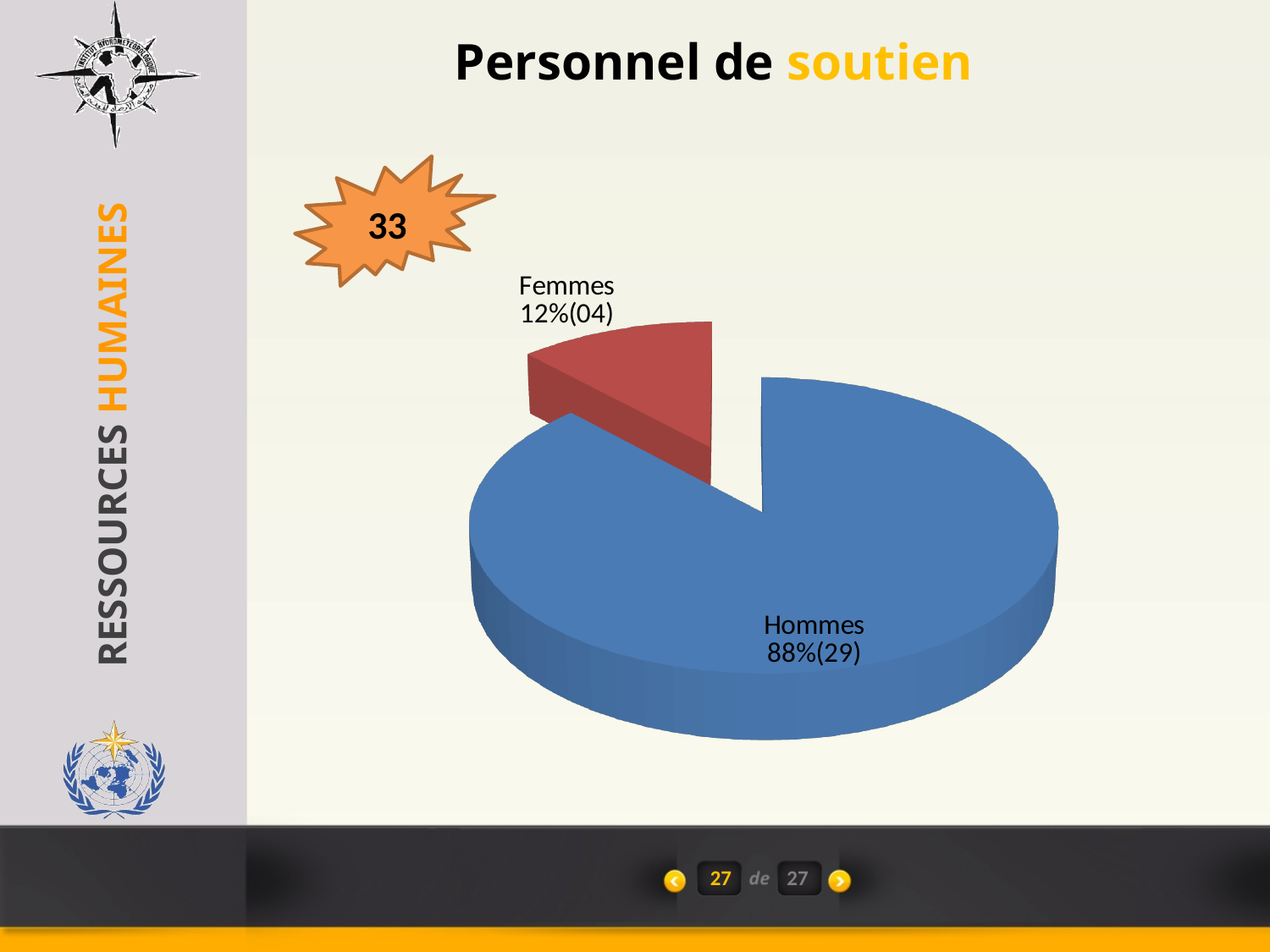
What share of the pie does Hommes represent? 88% What is the difference in percentage points between Hommes and Femmes? 76 What is the total number of personnel shown in the starburst shape on the slide? 33 Which category has the largest slice of the pie? Hommes Which is larger, the share for Hommes or the share for Femmes? Hommes What share of the pie does Femmes represent? 12% How many categories does the pie chart show? 2 What colour is the Femmes slice of the pie? red What kind of chart is shown on the slide? pie chart Which category has the smallest slice of the pie? Femmes How many Femmes are shown in the chart? 04 How many Hommes are shown in the chart? 29